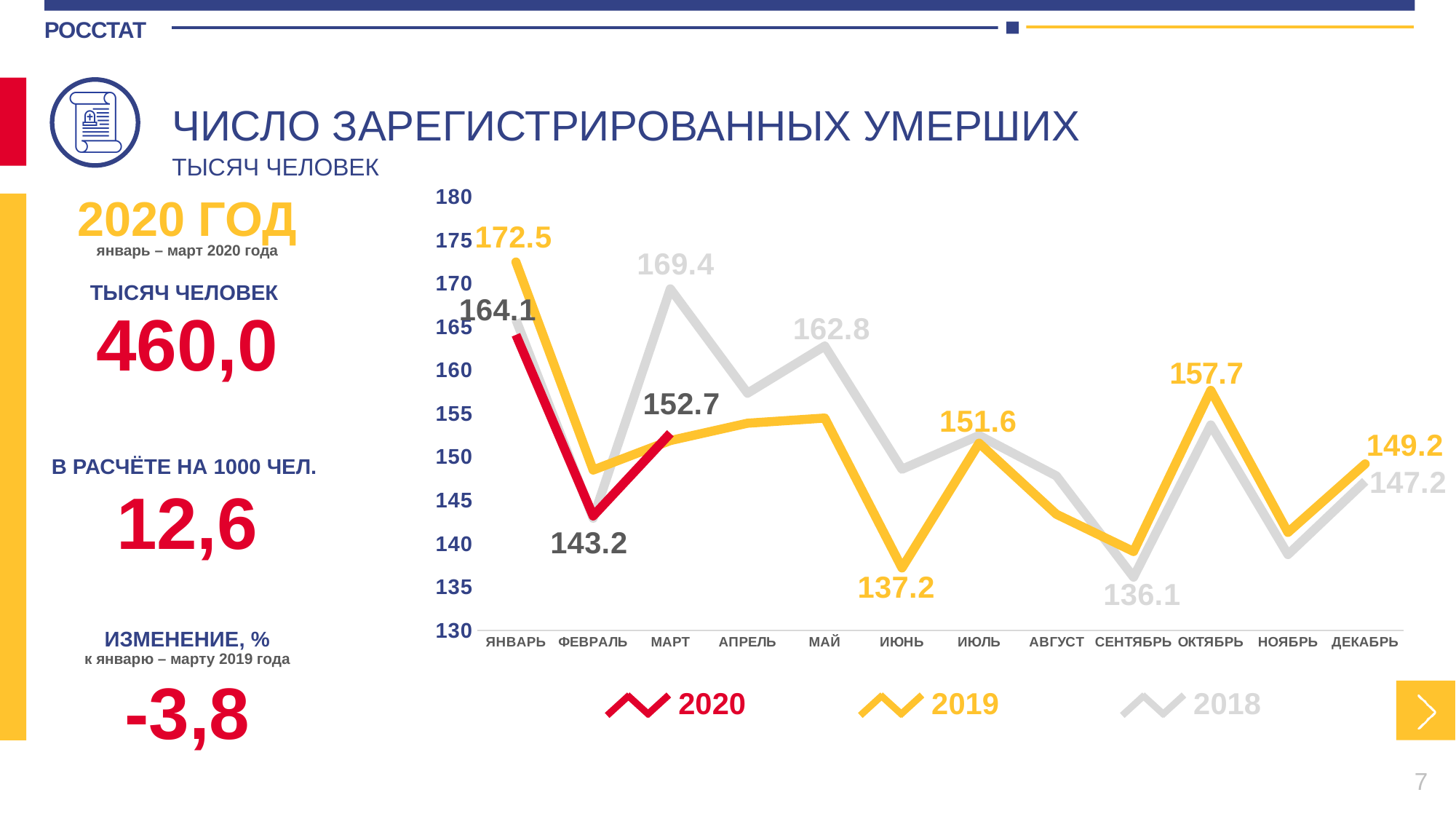
Which colour represents the 2020 series in the chart? red What is the value for 2020 in February (ФЕВРАЛЬ)? 143.2 How many series does the legend list? 3 What is the difference between the 2020 values for January and February? 20.9 What is the difference between the 2019 and 2018 values in December (ДЕКАБРЬ)? 2.0 Is the 2019 value for April (АПРЕЛЬ) greater or less than 150? greater Which is larger in January: the 2019 value or the 2020 value? 2019 What is the value for 2018 in September (СЕНТЯБРЬ)? 136.1 What kind of chart is shown on the slide? line chart What is the value for 2019 in January (ЯНВАРЬ)? 172.5 What is the value for 2020 in January (ЯНВАРЬ)? 164.1 What is the value for 2019 in October (ОКТЯБРЬ)? 157.7